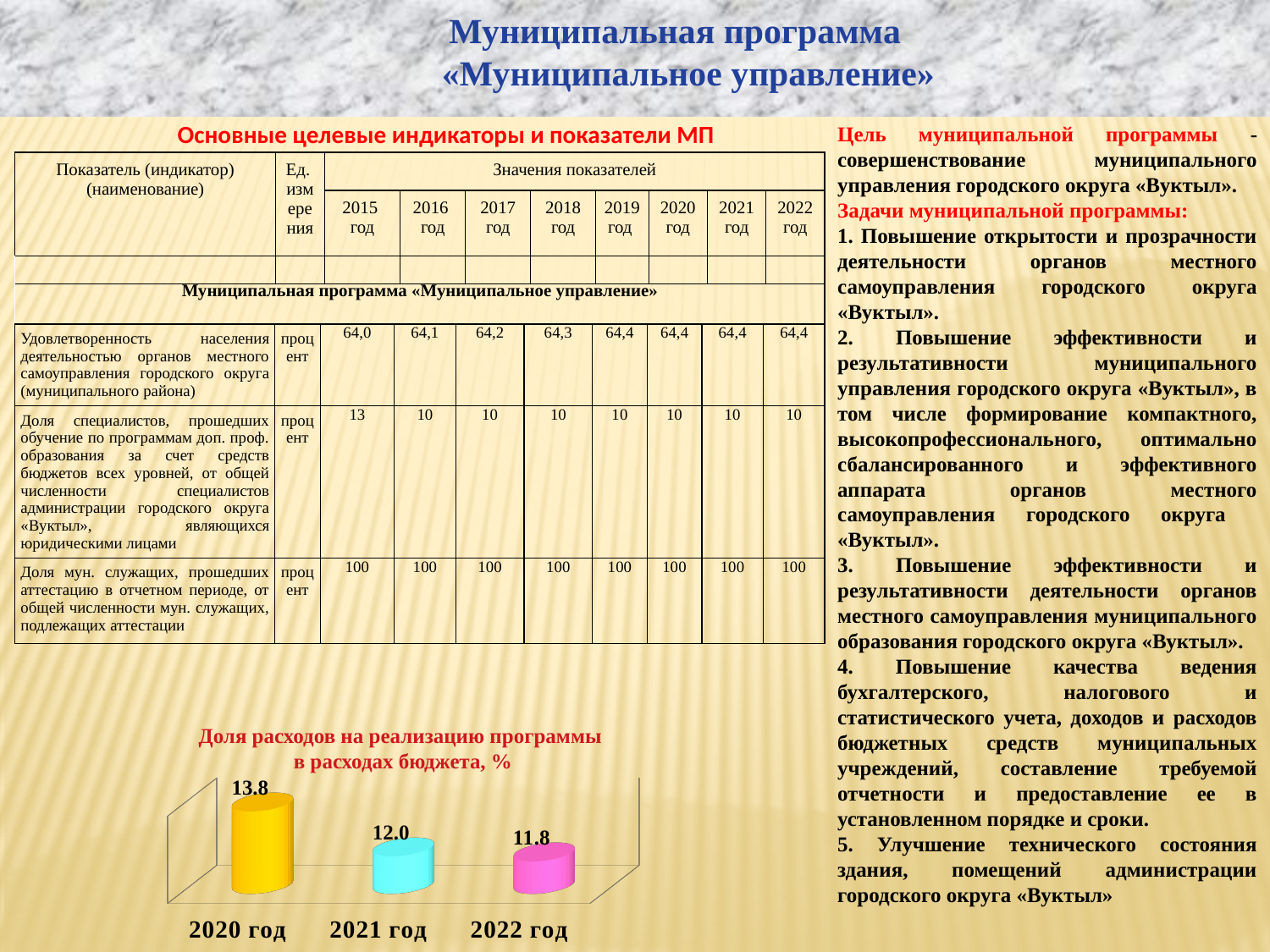
How many years (categories) are shown in the chart "Доля расходов на реализацию программы в расходах бюджета, %"? 3 What is the value for 2022 год in the chart "Доля расходов на реализацию программы в расходах бюджета, %"? 11.8 What is the title of the chart at the bottom of the slide? Доля расходов на реализацию программы в расходах бюджета, % In the chart "Доля расходов на реализацию программы в расходах бюджета, %", which is larger: the value for 2020 год or the value for 2021 год? 2020 год What is the value for 2020 год in the chart "Доля расходов на реализацию программы в расходах бюджета, %"? 13.8 What is the difference between the values for 2020 год and 2021 год in the chart "Доля расходов на реализацию программы в расходах бюджета, %"? 1.8 Which year has the lowest value in the chart "Доля расходов на реализацию программы в расходах бюджета, %"? 2022 год Which year has the highest value in the chart "Доля расходов на реализацию программы в расходах бюджета, %"? 2020 год What is the value for 2021 год in the chart "Доля расходов на реализацию программы в расходах бюджета, %"? 12.0 What kind of chart is "Доля расходов на реализацию программы в расходах бюджета, %"? bar chart What is the difference between the values for 2020 год and 2022 год in the chart "Доля расходов на реализацию программы в расходах бюджета, %"? 2.0 Do the values in the chart "Доля расходов на реализацию программы в расходах бюджета, %" rise or fall from 2020 год to 2022 год? fall